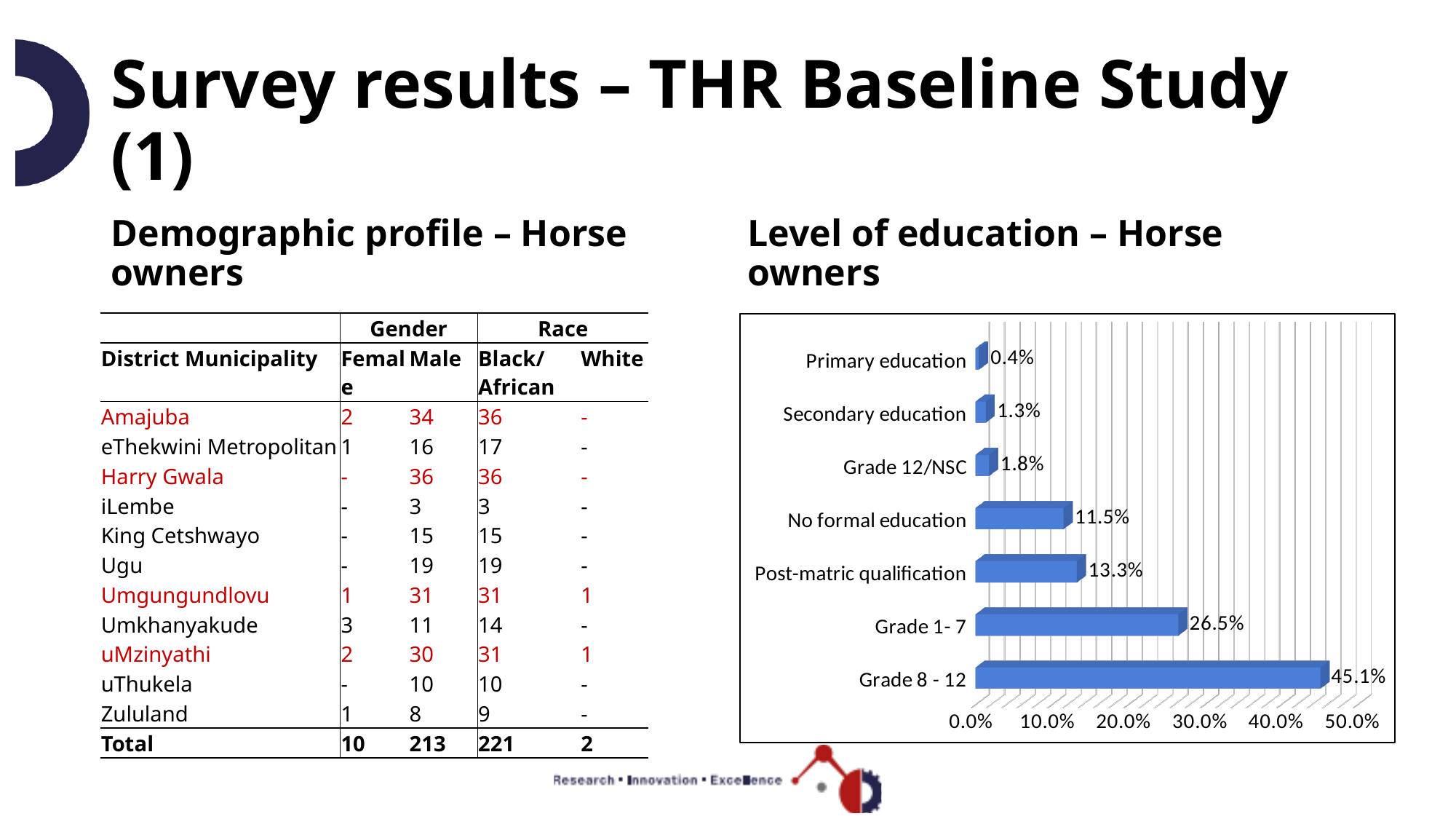
What is the difference between the values for Grade 8 - 12 and Grade 1- 7? 18.6% Which education level has the lowest share of horse owners? Primary education What is the value for Post-matric qualification in the level of education chart? 13.3% What is the value for No formal education in the level of education chart? 11.5% What is the value for Grade 8 - 12 in the level of education chart? 45.1% What is the value for Primary education in the level of education chart? 0.4% What is the title of the chart on the right of the slide? Level of education – Horse owners Which is larger in the level of education chart: Post-matric qualification or No formal education? Post-matric qualification How many education categories are shown in the level of education chart? 7 What kind of chart is used to show the level of education of horse owners? bar chart Is the value for Grade 1- 7 greater or less than 20.0%? greater Which education level has the highest share of horse owners? Grade 8 - 12